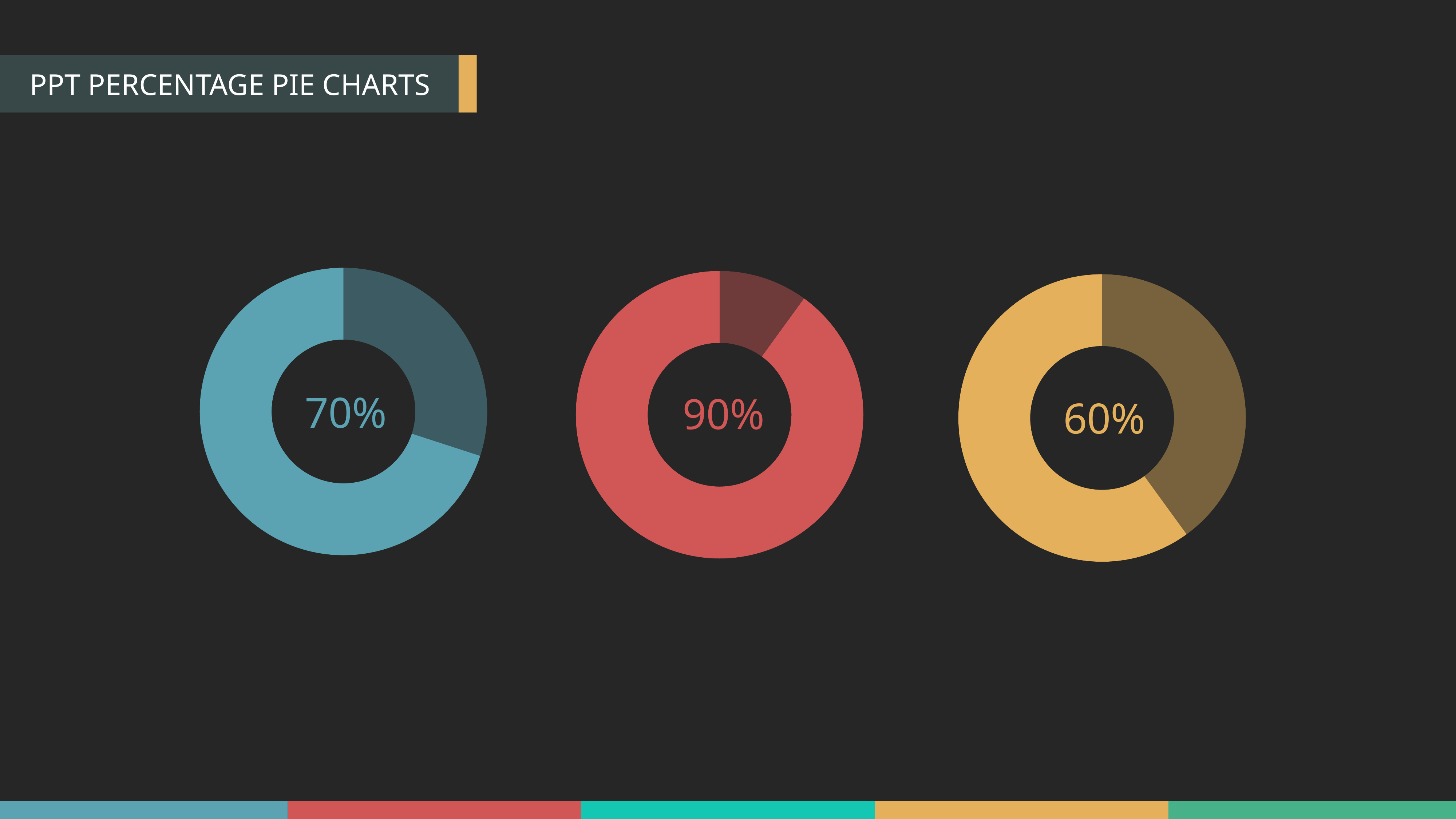
How many donut charts are shown on the slide? 3 What kind of chart is used on this slide? Donut (pie) chart What colour is the donut chart that shows 90%? Red What is the difference between the percentage in the middle chart and the percentage in the left chart? 20% What percentage is shown in the centre of the middle donut chart? 90% Which of the three donut charts shows the lowest percentage? The right chart (60%) Which of the three donut charts shows the highest percentage? The middle chart (90%) What percentage is shown in the centre of the right donut chart? 60% What percentage is shown in the centre of the left donut chart? 70% What is the title of the slide? PPT PERCENTAGE PIE CHARTS What is the difference between the percentage in the left chart and the percentage in the right chart? 10% Is the percentage in the left chart larger or smaller than the percentage in the right chart? Larger